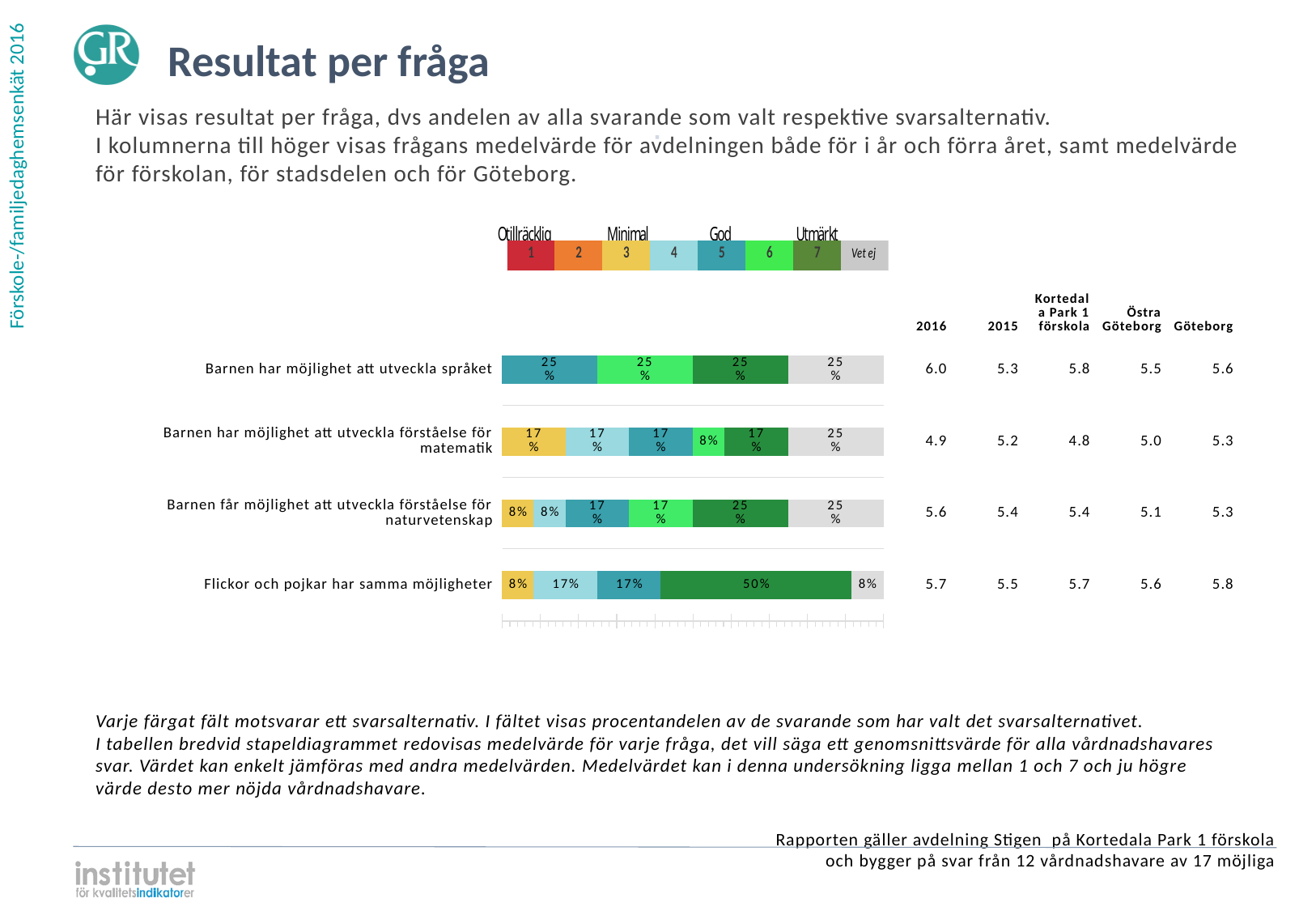
How many response options does the legend above the chart list, including 'Vet ej'? 8 What is the Göteborg mean value for 'Barnen har möjlighet att utveckla förståelse för matematik'? 5.3 Which is larger for 'Barnen får möjlighet att utveckla förståelse för naturvetenskap': the 2016 mean or the Östra Göteborg mean? 2016 mean What kind of chart is shown on the slide? Stacked bar chart What percentage of respondents answered 'Vet ej' for 'Barnen har möjlighet att utveckla språket'? 25% Which question has the largest single segment in its bar? Flickor och pojkar har samma möjligheter How many questions (categories) are plotted in the bar chart? 4 What percentage of respondents chose option 7 (dark green) for 'Flickor och pojkar har samma möjligheter'? 50% What is the difference between the 2016 and 2015 mean values for 'Barnen har möjlighet att utveckla språket'? 0.7 What percentage chose option 6 (light green) for 'Barnen har möjlighet att utveckla förståelse för matematik'? 8% Which question has the lowest 2016 mean value? Barnen har möjlighet att utveckla förståelse för matematik What is the 2016 mean value for 'Barnen har möjlighet att utveckla språket'? 6.0